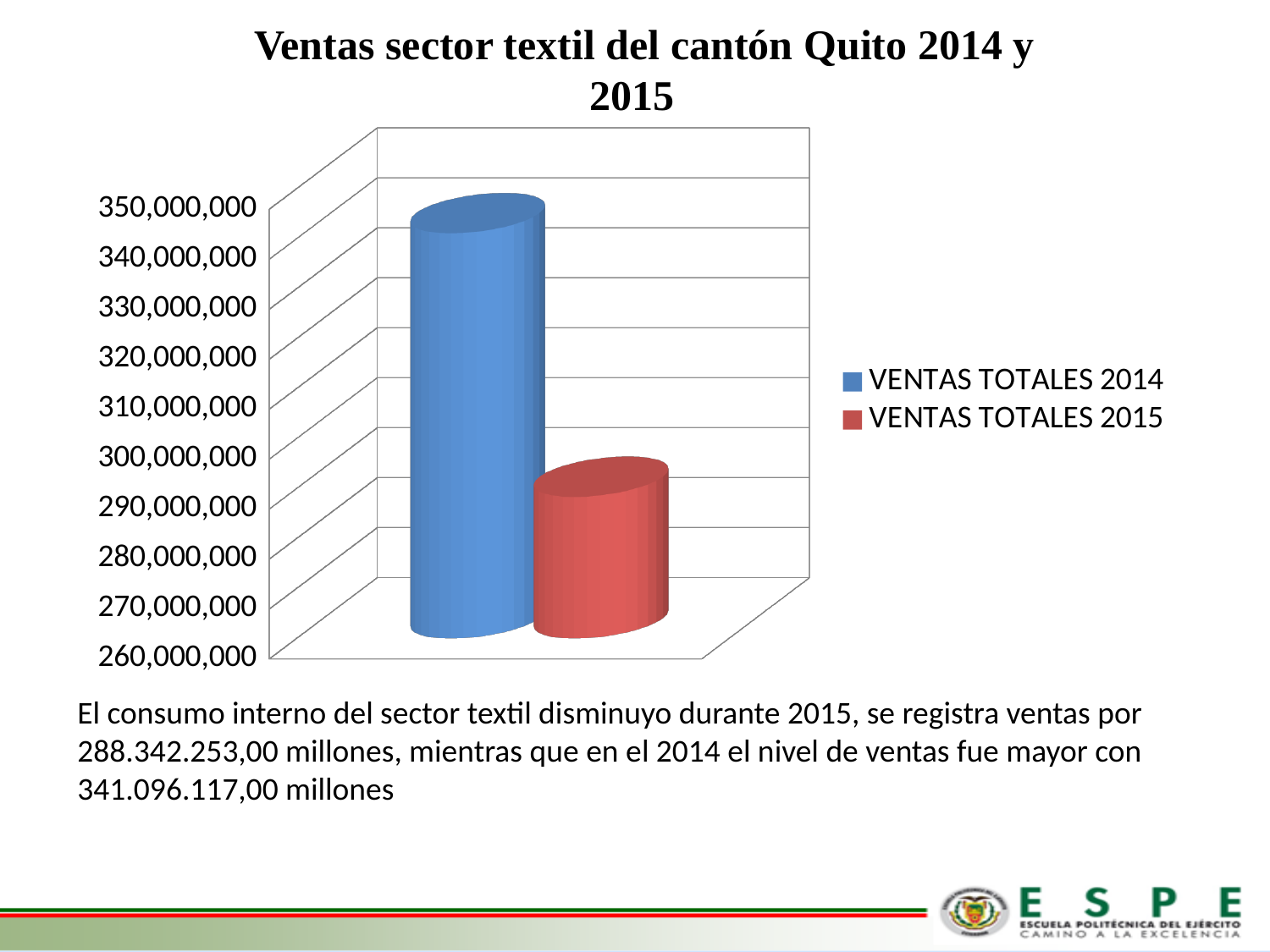
What kind of chart is shown on the slide? bar chart How many series does the legend list? 2 Is the value for VENTAS TOTALES 2015 greater or less than 300,000,000? less What colour represents VENTAS TOTALES 2015 in the chart? red Which series has the lowest value in the chart? VENTAS TOTALES 2015 Is the value for VENTAS TOTALES 2014 greater or less than 330,000,000? greater Do the sales values rise or fall from 2014 to 2015? fall How many bars are plotted in the chart? 2 Is the value for VENTAS TOTALES 2015 greater or less than 280,000,000? greater Is the value for VENTAS TOTALES 2014 larger or smaller than the value for VENTAS TOTALES 2015? larger What is the title of the chart? Ventas sector textil del cantón Quito 2014 y 2015 Which series has the highest value, VENTAS TOTALES 2014 or VENTAS TOTALES 2015? VENTAS TOTALES 2014